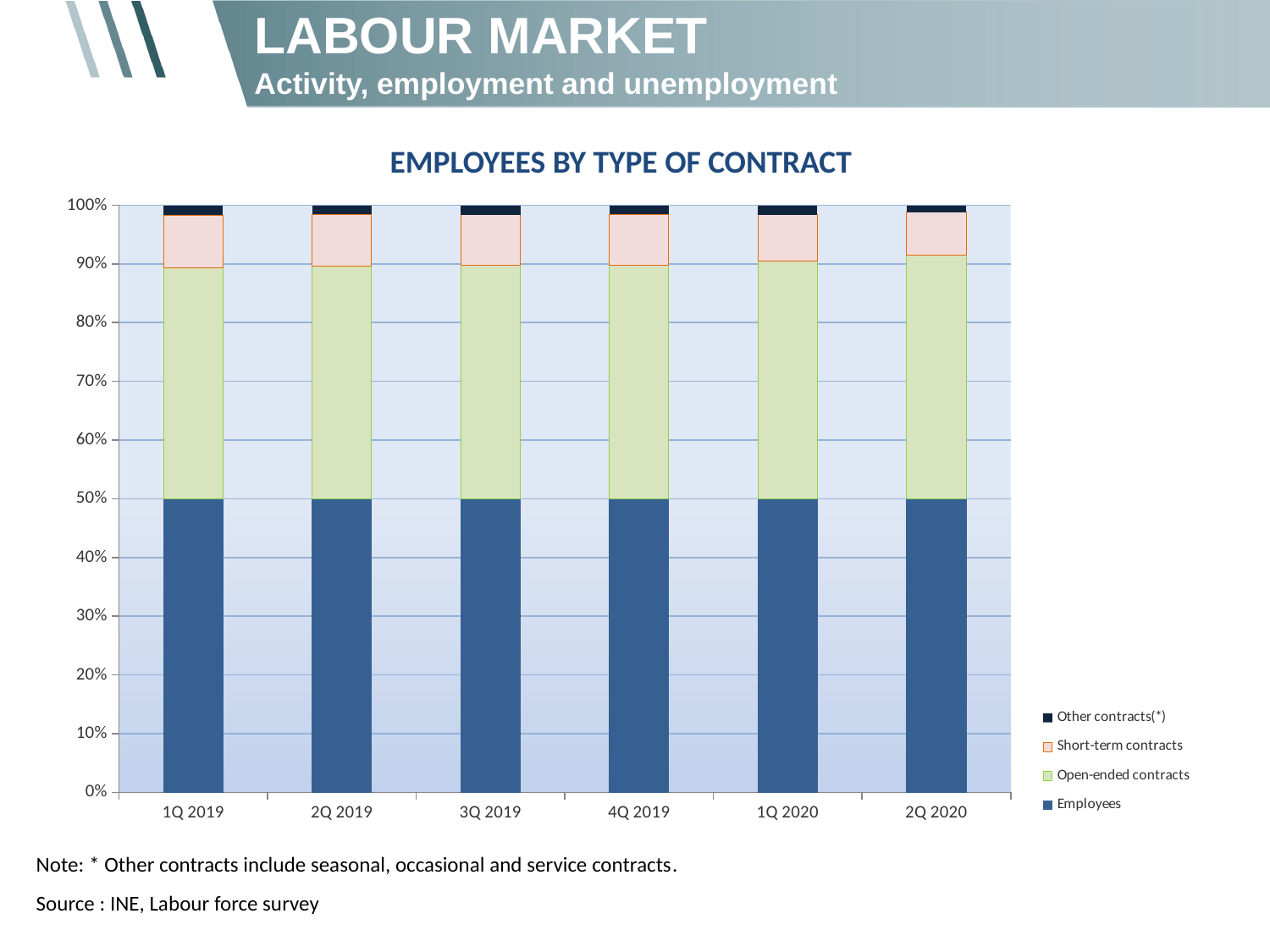
How many series does the chart legend list? 4 Is the Employees segment in 2Q 2020 greater or less than 40%? greater What type of chart is shown on the slide? Stacked bar chart In which quarter is the Short-term contracts segment the smallest? 2Q 2020 Is the Short-term contracts segment in 1Q 2019 greater or less than 10%? less In 1Q 2019, which segment is larger: Open-ended contracts or Short-term contracts? Open-ended contracts Is the Other contracts(*) segment in 4Q 2019 greater or less than 10%? less What is the title of the chart? EMPLOYEES BY TYPE OF CONTRACT How many quarters are shown on the x axis of the chart? 6 In which quarter is the Open-ended contracts segment the largest? 2Q 2020 What share does the Employees segment reach in 1Q 2019? 50% Which series is shown in dark blue at the bottom of each bar? Employees